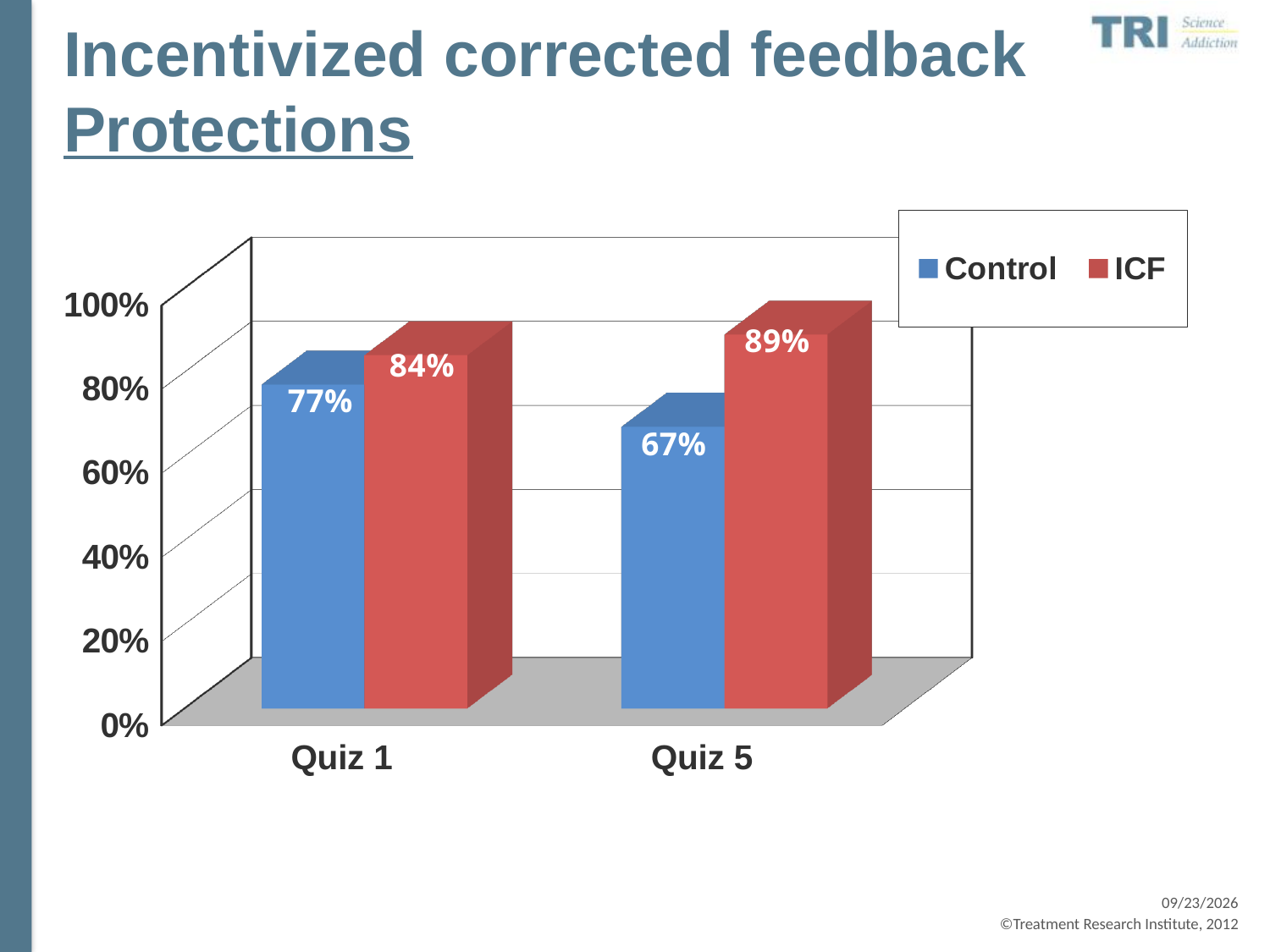
What is the Control value for Quiz 1? 77% What is the difference between the ICF and Control values for Quiz 5? 22% What is the difference between the ICF and Control values for Quiz 1? 7% What is the ICF value for Quiz 5? 89% What is the ICF value for Quiz 1? 84% Which is larger for Quiz 1, Control or ICF? ICF Which bar has the lowest value on the chart? Control, Quiz 5 What kind of chart is shown on the slide? Bar chart What is the Control value for Quiz 5? 67% How many quiz categories are shown on the x axis? 2 Which bar has the highest value on the chart? ICF, Quiz 5 How many series does the legend list? 2